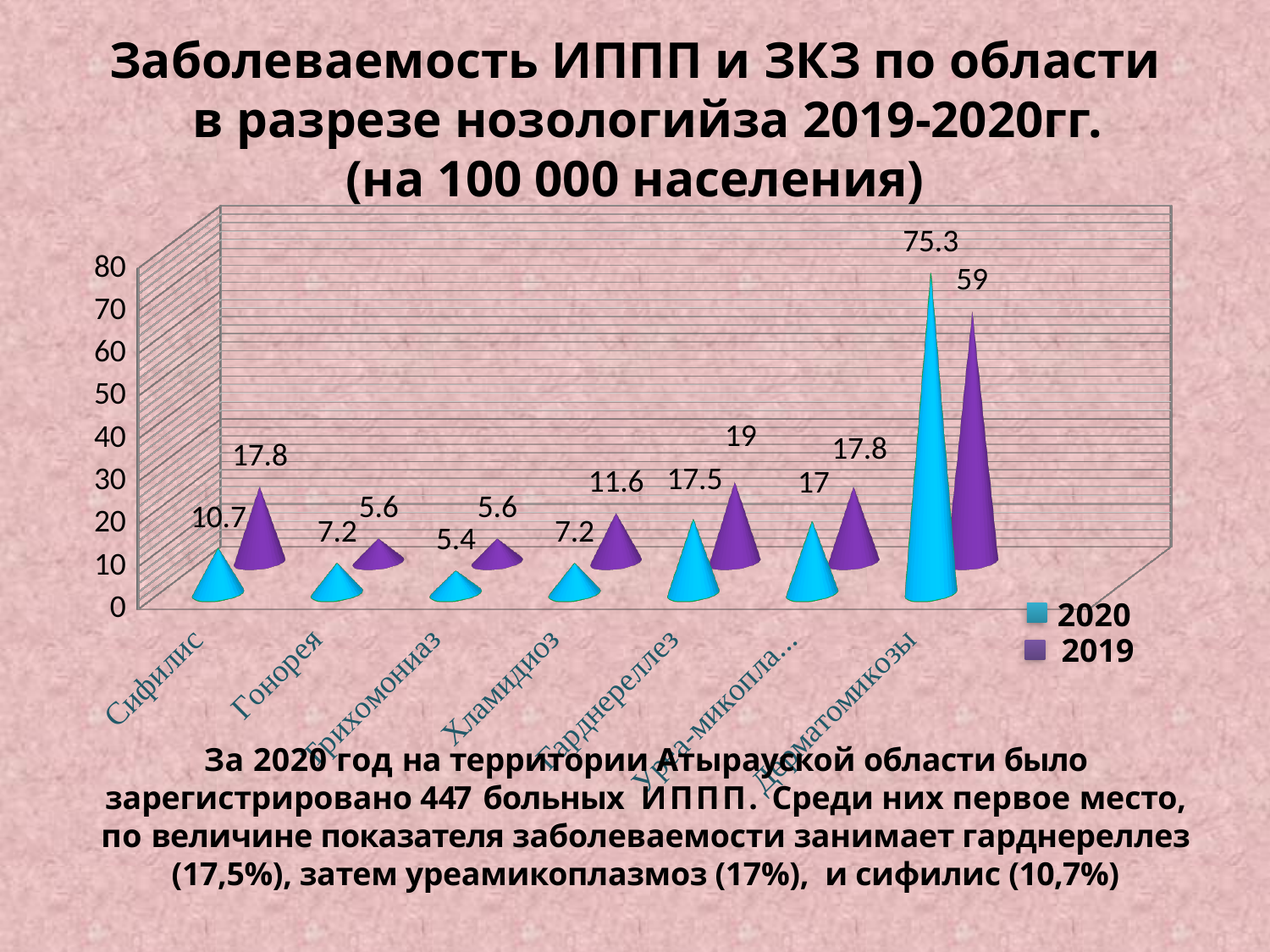
Which category has the highest 2020 value? Дерматомикозы What is the 2019 value for Гарднереллез? 19 What is the difference between the 2019 and 2020 values for Сифилис? 7.1 Which colour represents the 2020 series in the legend? Cyan (light blue) What is the 2020 value for Сифилис? 10.7 How many categories are shown on the x axis? 7 What is the difference between the 2020 and 2019 values for Дерматомикозы? 16.3 What kind of chart is shown on the slide? Bar chart For Сифилис, which year has the larger value, 2020 or 2019? 2019 What is the 2020 value for Хламидиоз? 7.2 What is the 2019 value for Хламидиоз? 11.6 How many series does the legend list? 2